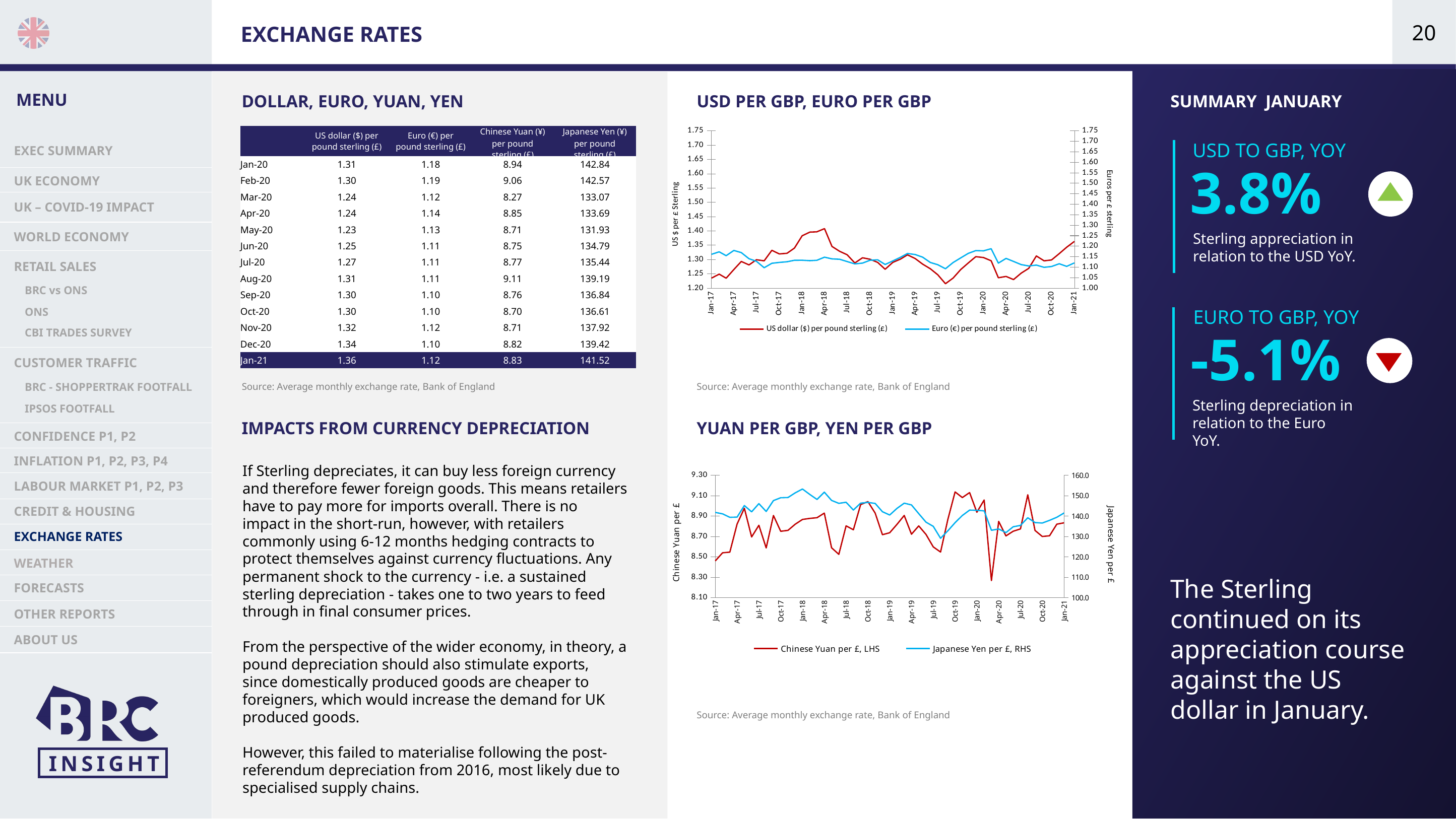
In the 'YUAN PER GBP, YEN PER GBP' chart, is the value of Japanese Yen per £ at Jan-18 greater or less than 140.0 on the right axis? greater How many series does the legend of the 'USD PER GBP, EURO PER GBP' chart list? 2 In the 'YUAN PER GBP, YEN PER GBP' chart, which series is plotted on the right-hand axis according to the legend? Japanese Yen per £, RHS In the 'USD PER GBP, EURO PER GBP' chart, is the US dollar ($) per pound sterling (£) value higher at Apr-18 or at Jul-19? Apr-18 In the 'USD PER GBP, EURO PER GBP' chart, does the US dollar ($) per pound sterling (£) line rise or fall between Jul-20 and Jan-21? rise How many series does the legend of the 'YUAN PER GBP, YEN PER GBP' chart list? 2 In the 'YUAN PER GBP, YEN PER GBP' chart, is the Chinese Yuan per £ value higher at Oct-19 or at Apr-20? Oct-19 What kind of chart is the 'USD PER GBP, EURO PER GBP' chart? line chart In the 'USD PER GBP, EURO PER GBP' chart, is the value of US dollar ($) per pound sterling (£) at Jan-21 greater or less than 1.30? greater In the 'USD PER GBP, EURO PER GBP' chart, is the value of Euro (€) per pound sterling (£) at Jan-21 greater or less than 1.20 on the right axis? less What kind of chart is the 'YUAN PER GBP, YEN PER GBP' chart? line chart